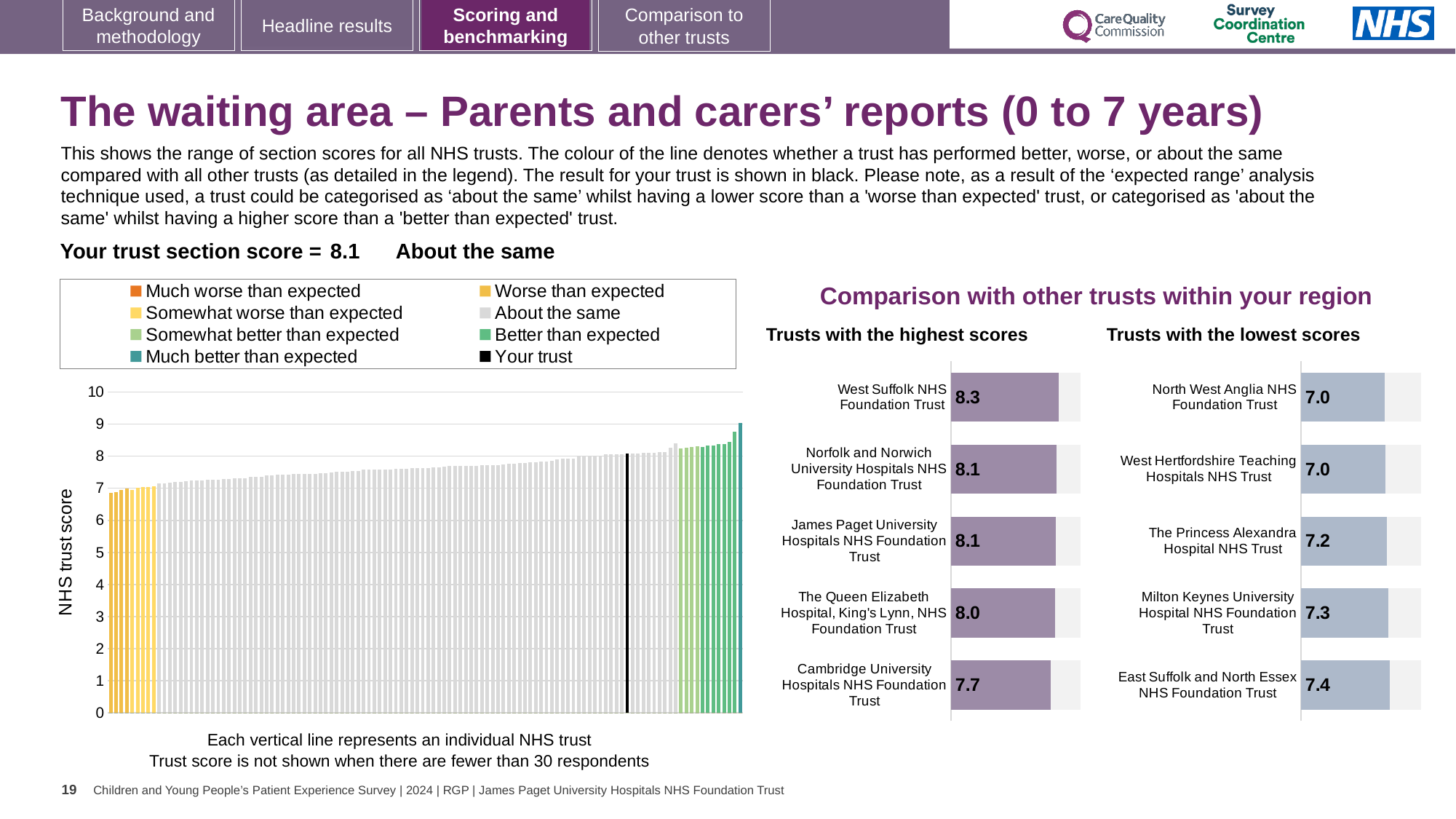
In the 'Trusts with the lowest scores' chart, what is the score for The Princess Alexandra Hospital NHS Trust? 7.2 In the 'Trusts with the lowest scores' chart, which has the larger score: Milton Keynes University Hospital NHS Foundation Trust or The Princess Alexandra Hospital NHS Trust? Milton Keynes University Hospital NHS Foundation Trust In the large chart on the left, do the NHS trust scores rise or fall from left to right? Rise In the 'Trusts with the highest scores' chart, what is the score for West Suffolk NHS Foundation Trust? 8.3 In the 'Trusts with the lowest scores' chart, what is the score for East Suffolk and North Essex NHS Foundation Trust? 7.4 In the 'Trusts with the highest scores' chart, what is the difference between the scores of West Suffolk NHS Foundation Trust and Cambridge University Hospitals NHS Foundation Trust? 0.6 How many trusts are shown in the 'Trusts with the lowest scores' chart? 5 What type of chart is the large chart on the left showing NHS trust scores? Bar chart How many entries does the legend above the large chart on the left list? 8 In the 'Trusts with the highest scores' chart, what is the score for Cambridge University Hospitals NHS Foundation Trust? 7.7 In the 'Trusts with the highest scores' chart, which trust has the highest score? West Suffolk NHS Foundation Trust In the 'Trusts with the lowest scores' chart, which trust has the highest score shown? East Suffolk and North Essex NHS Foundation Trust